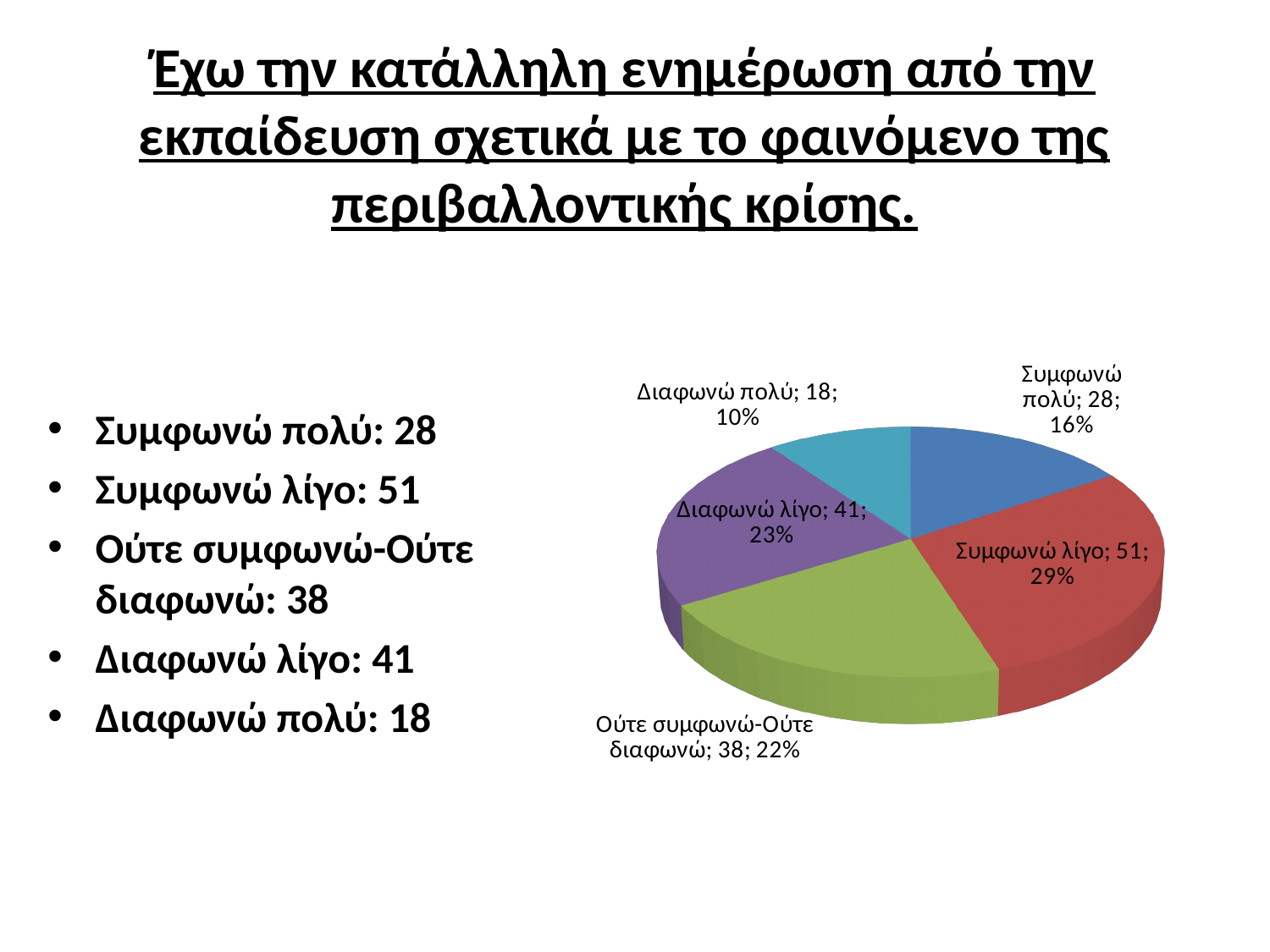
Which is larger, the value for Συμφωνώ πολύ or the value for Ούτε συμφωνώ-Ούτε διαφωνώ? Ούτε συμφωνώ-Ούτε διαφωνώ What percentage share does Διαφωνώ λίγο have in the pie chart? 23% What is the value for Ούτε συμφωνώ-Ούτε διαφωνώ in the pie chart? 38 How many slices does the pie chart have? 5 What colour is the Συμφωνώ λίγο slice in the pie chart? red Which category has the largest slice in the pie chart? Συμφωνώ λίγο What is the difference between the values for Συμφωνώ λίγο and Διαφωνώ λίγο? 10 What is the value for Συμφωνώ λίγο in the pie chart? 51 Which category has the smallest slice in the pie chart? Διαφωνώ πολύ What is the value for Διαφωνώ πολύ in the pie chart? 18 What percentage share does Συμφωνώ πολύ have in the pie chart? 16% What type of chart is shown on the slide? pie chart